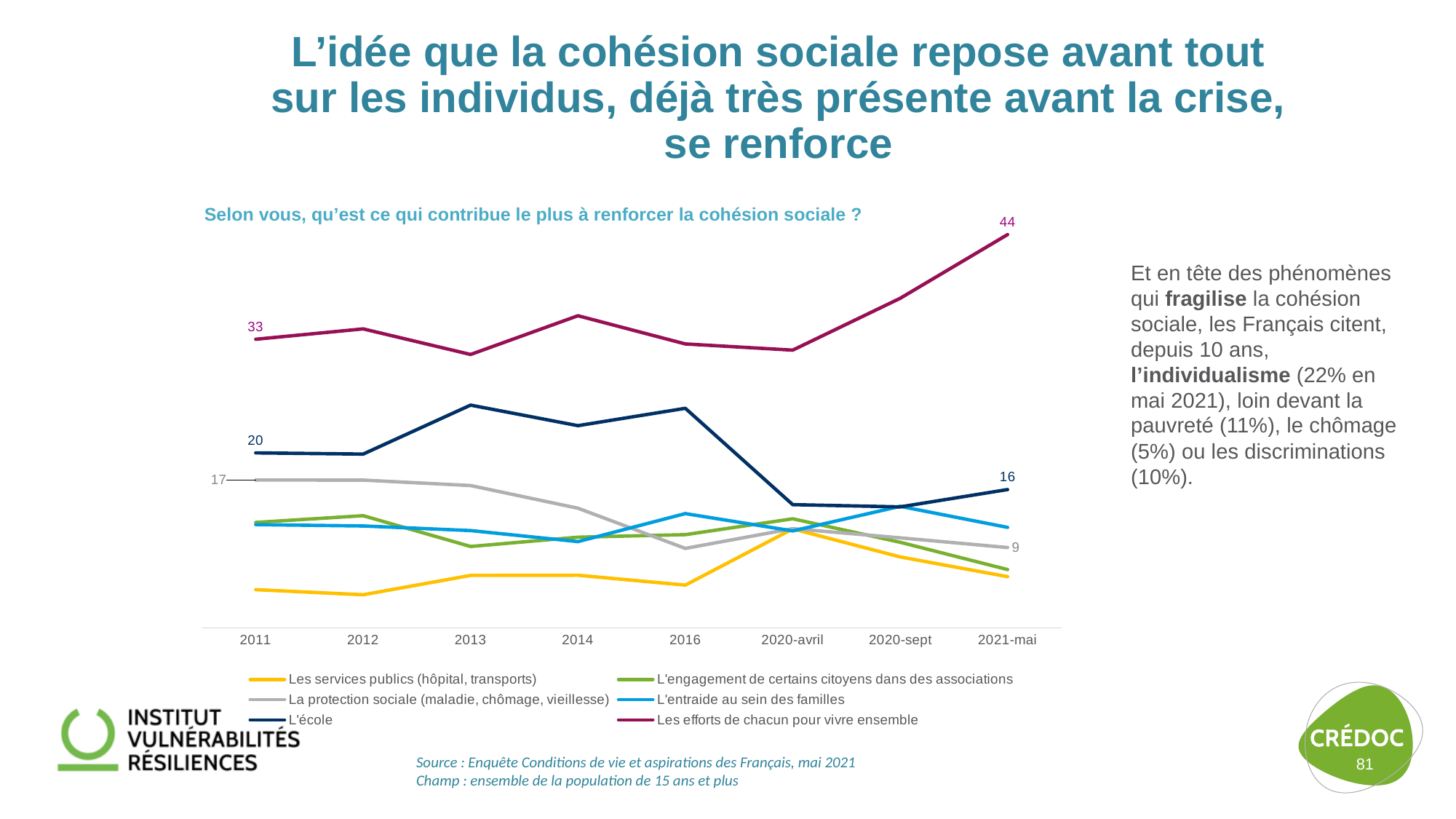
What is the value for 'La protection sociale (maladie, chômage, vieillesse)' in 2021-mai? 9 How many time points are shown on the x axis? 8 How many series does the legend list? 6 Which series has the highest value in 2021-mai? Les efforts de chacun pour vivre ensemble What is the value for 'Les efforts de chacun pour vivre ensemble' in 2011? 33 What kind of chart is shown on the slide? line chart What is the value for 'Les efforts de chacun pour vivre ensemble' in 2021-mai? 44 Did the value for 'La protection sociale (maladie, chômage, vieillesse)' rise or fall between 2011 and 2021-mai? fall What is the value for 'L'école' in 2021-mai? 16 What is the value for 'L'école' in 2011? 20 Which series has the lowest value in 2011? Les services publics (hôpital, transports) By how much did 'Les efforts de chacun pour vivre ensemble' change between 2011 and 2021-mai? 11